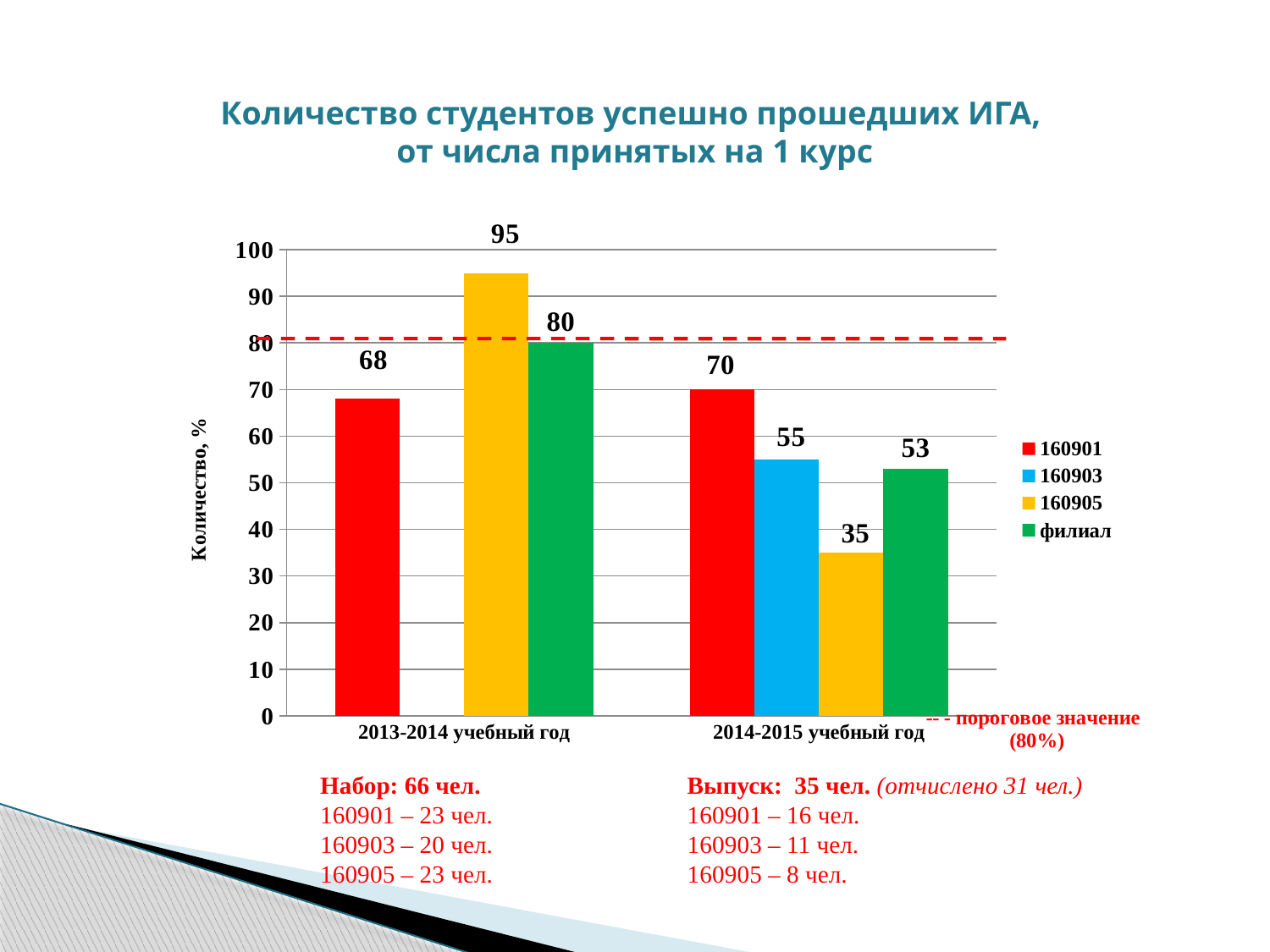
Which series has the highest value in 2013-2014 учебный год? 160905 What is the value for 160901 in 2014-2015 учебный год? 70 What threshold value does the red dashed line mark? 80% What type of chart is shown on the slide? bar chart Which series has the lowest value in 2014-2015 учебный год? 160905 Which is larger: the value for 160901 in 2013-2014 or in 2014-2015? 2014-2015 What is the value for 160903 in 2014-2015 учебный год? 55 What is the value for 160905 in 2013-2014 учебный год? 95 What is the difference between the 160905 values for 2013-2014 and 2014-2015? 60 How many series does the legend list? 4 What is the value for филиал in 2014-2015 учебный год? 53 How many academic-year categories are shown on the x axis? 2